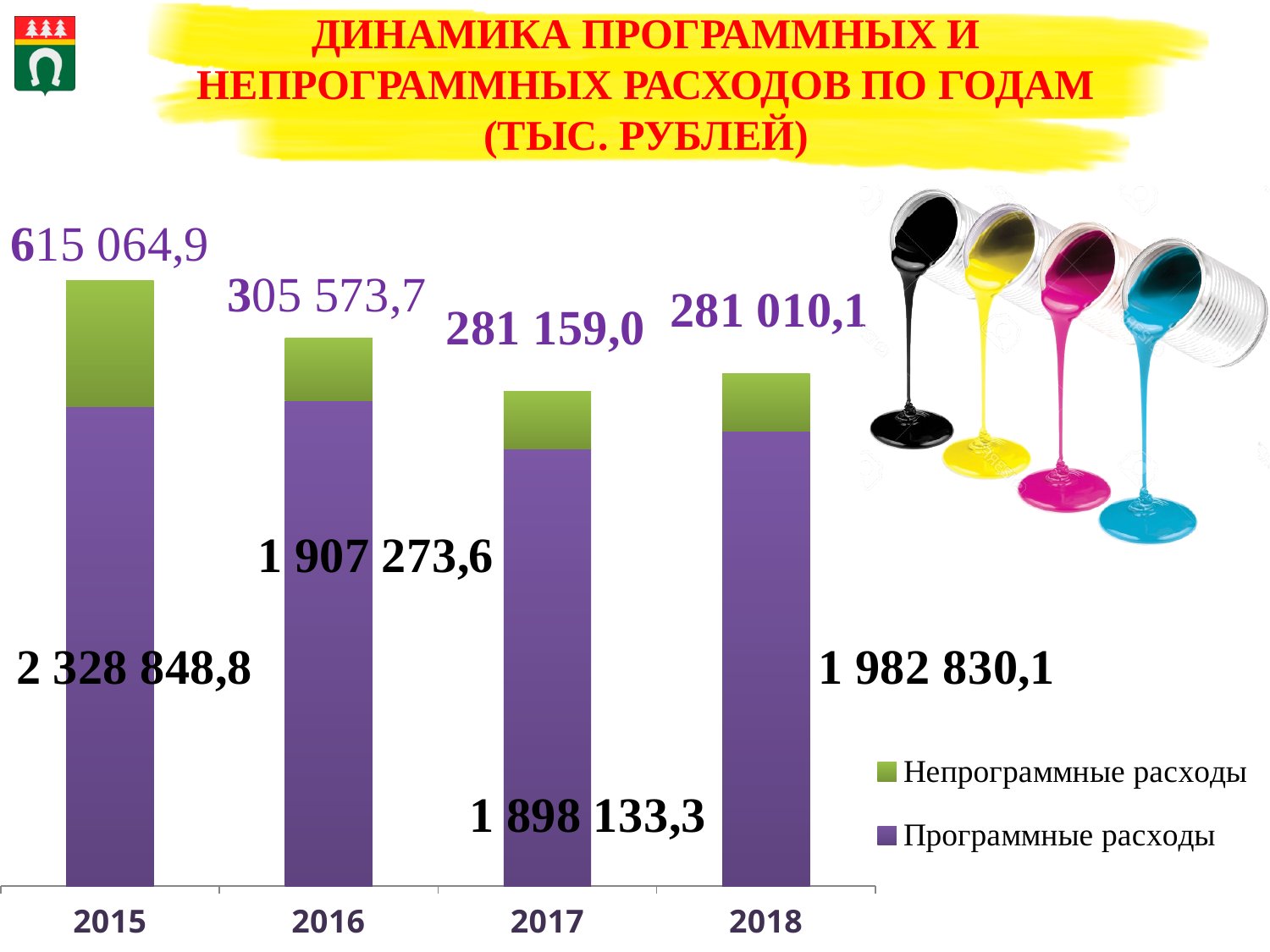
What is the total of the stacked bar for 2016? 2 212 847,3 What is the value of Программные расходы for 2018? 1 982 830,1 What is the value of Непрограммные расходы for 2017? 281 159,0 How many series does the legend list? 2 Which year has the highest value of Непрограммные расходы? 2015 Which year has the lowest value of Программные расходы? 2017 What is the value of Программные расходы for 2015? 2 328 848,8 What is the difference between Программные расходы in 2015 and in 2016? 421 575,2 What kind of chart is shown on the slide? Stacked bar chart Do the values of Непрограммные расходы rise or fall from 2015 to 2018? Fall How many years are shown on the x axis? 4